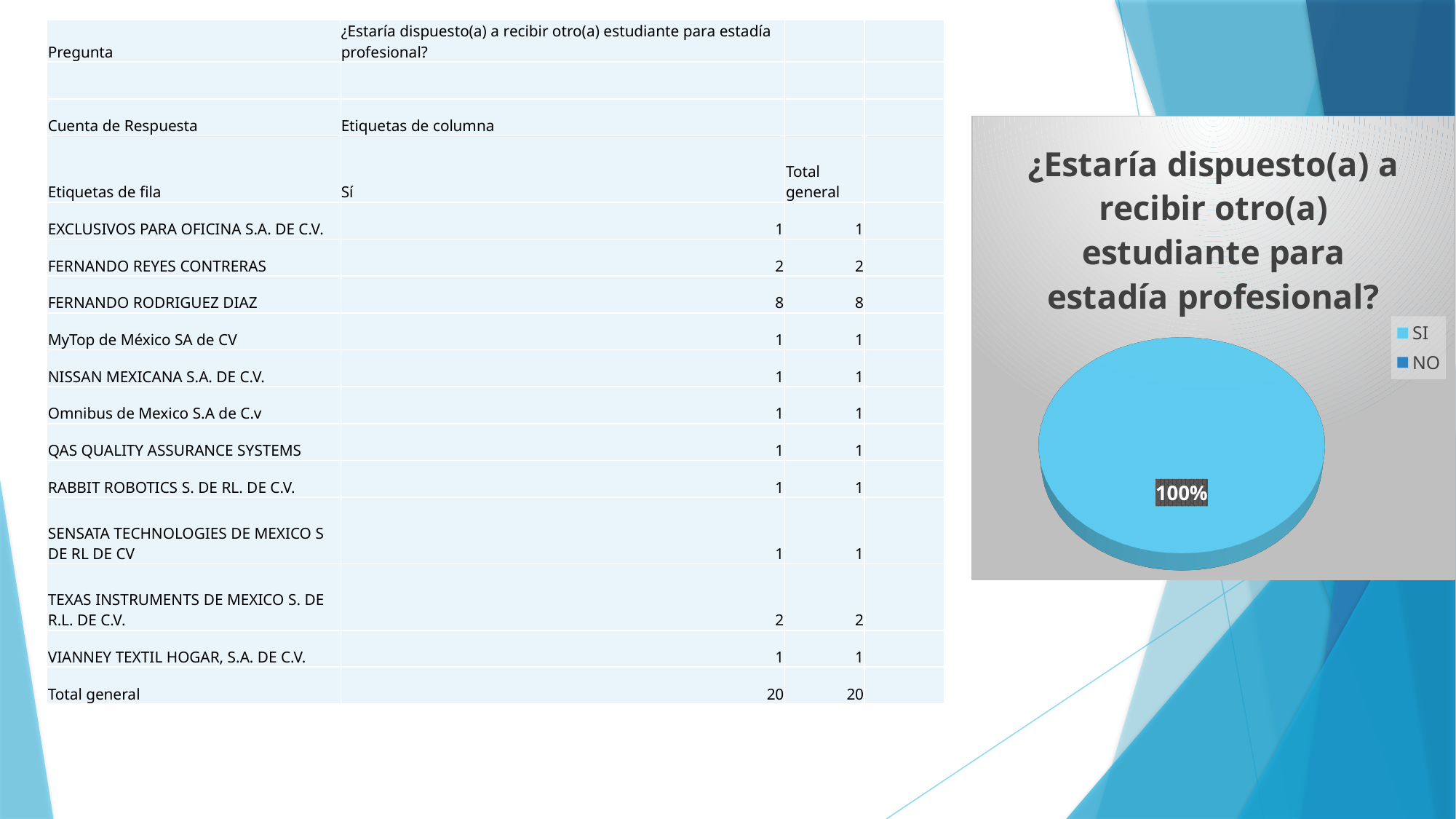
How many entries does the legend of the pie chart list? 2 Which legend entry corresponds to the slice labelled 100% in the pie chart? SI What kind of chart is shown on the right side of the slide? pie chart What is the title of the pie chart? ¿Estaría dispuesto(a) a recibir otro(a) estudiante para estadía profesional? Which category has the largest share in the pie chart? SI What are the two legend entries of the pie chart? SI and NO How many slices are visible in the pie chart? 1 What share of the pie chart does the SI slice represent? 100%